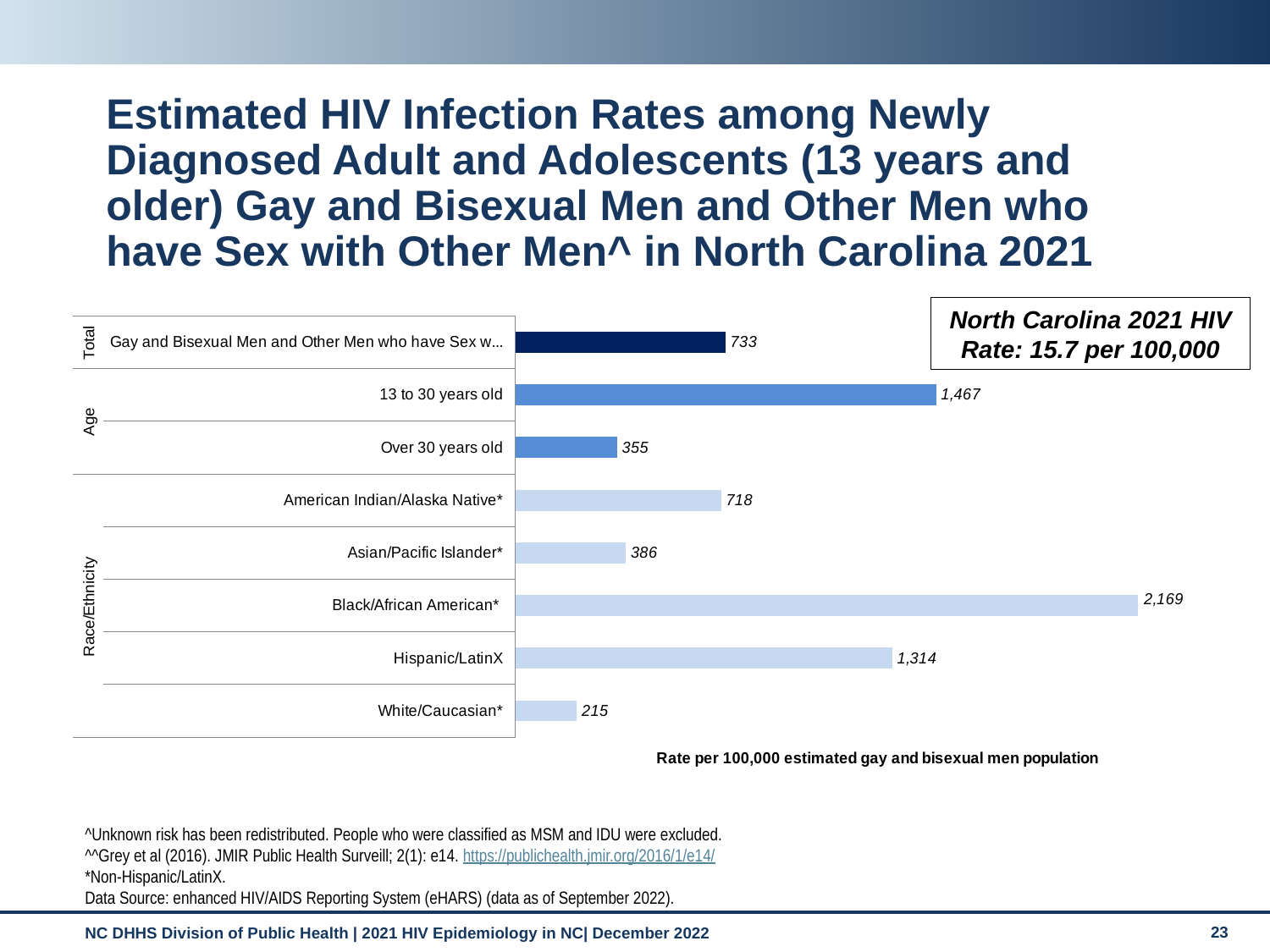
Which is larger, the rate for Hispanic/LatinX or the rate for American Indian/Alaska Native*? Hispanic/LatinX Which category has the highest rate? Black/African American* What is the North Carolina 2021 HIV rate per 100,000 shown in the text box? 15.7 per 100,000 What is the rate for 13 to 30 years old? 1,467 What is the difference between the rates for Black/African American* and Hispanic/LatinX? 855 What kind of chart is shown on the slide? Bar chart Which category has the lowest rate? White/Caucasian* What is the rate for Black/African American*? 2,169 What is the rate for White/Caucasian*? 215 How many bars are plotted in the chart? 8 What is the difference between the rates for 13 to 30 years old and Over 30 years old? 1,112 What is the rate for the Total bar (Gay and Bisexual Men and Other Men who have Sex w...)? 733